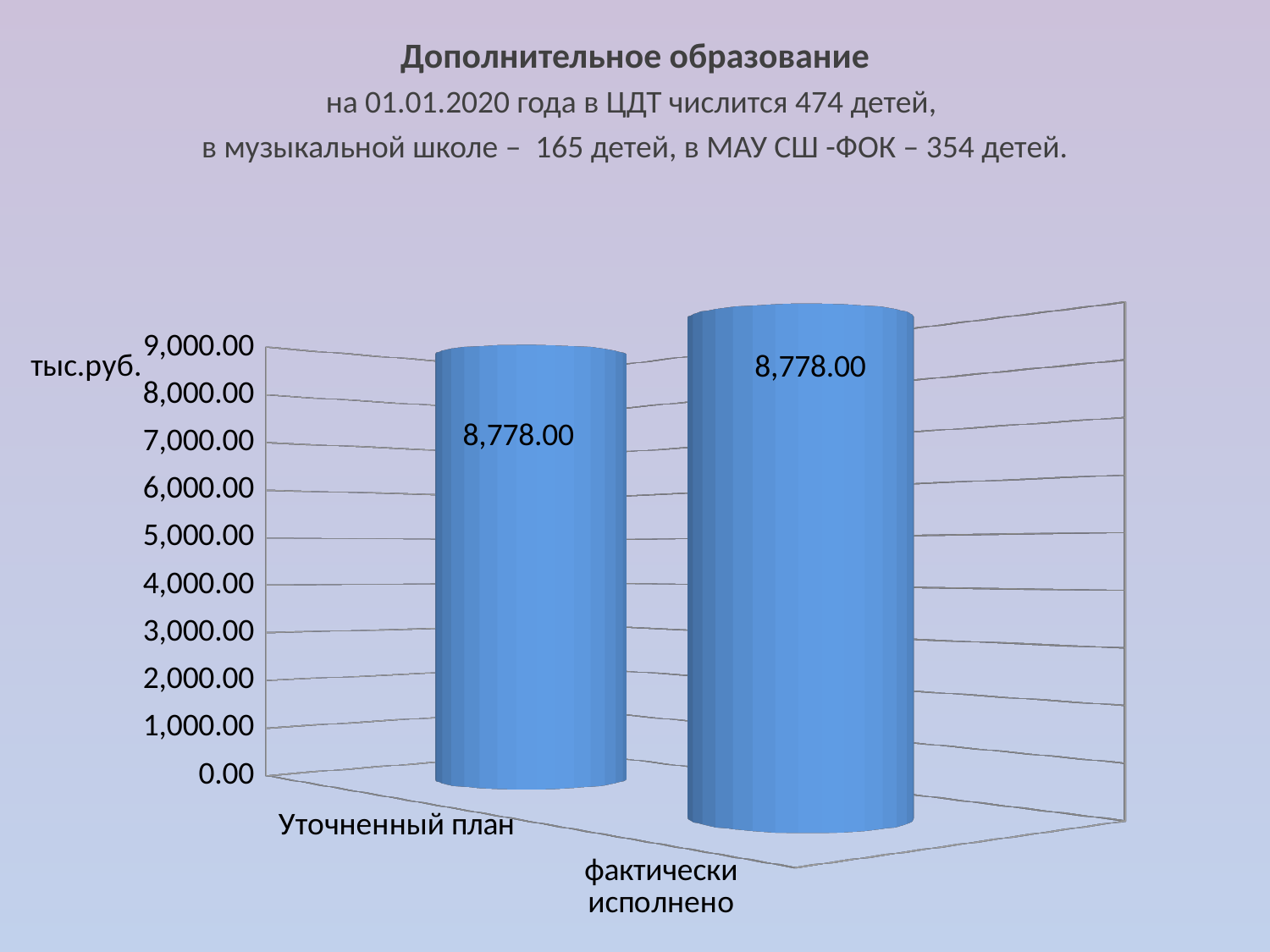
What kind of chart is shown on the slide? Bar chart What is the highest tick value shown on the vertical axis? 9,000.00 Which is larger, the value for Уточненный план or the value for фактически исполнено? They are equal Do the values rise, fall or stay the same from Уточненный план to фактически исполнено? Stay the same What is the value for фактически исполнено? 8,778.00 Is the value for Уточненный план greater or less than 9,000.00? less Is the value for фактически исполнено greater or less than 8,000.00? greater What is the difference between the values for Уточненный план and фактически исполнено? 0.00 What unit is shown next to the vertical axis of the chart? тыс.руб. What is the value for Уточненный план? 8,778.00 How many categories are plotted on the chart? 2